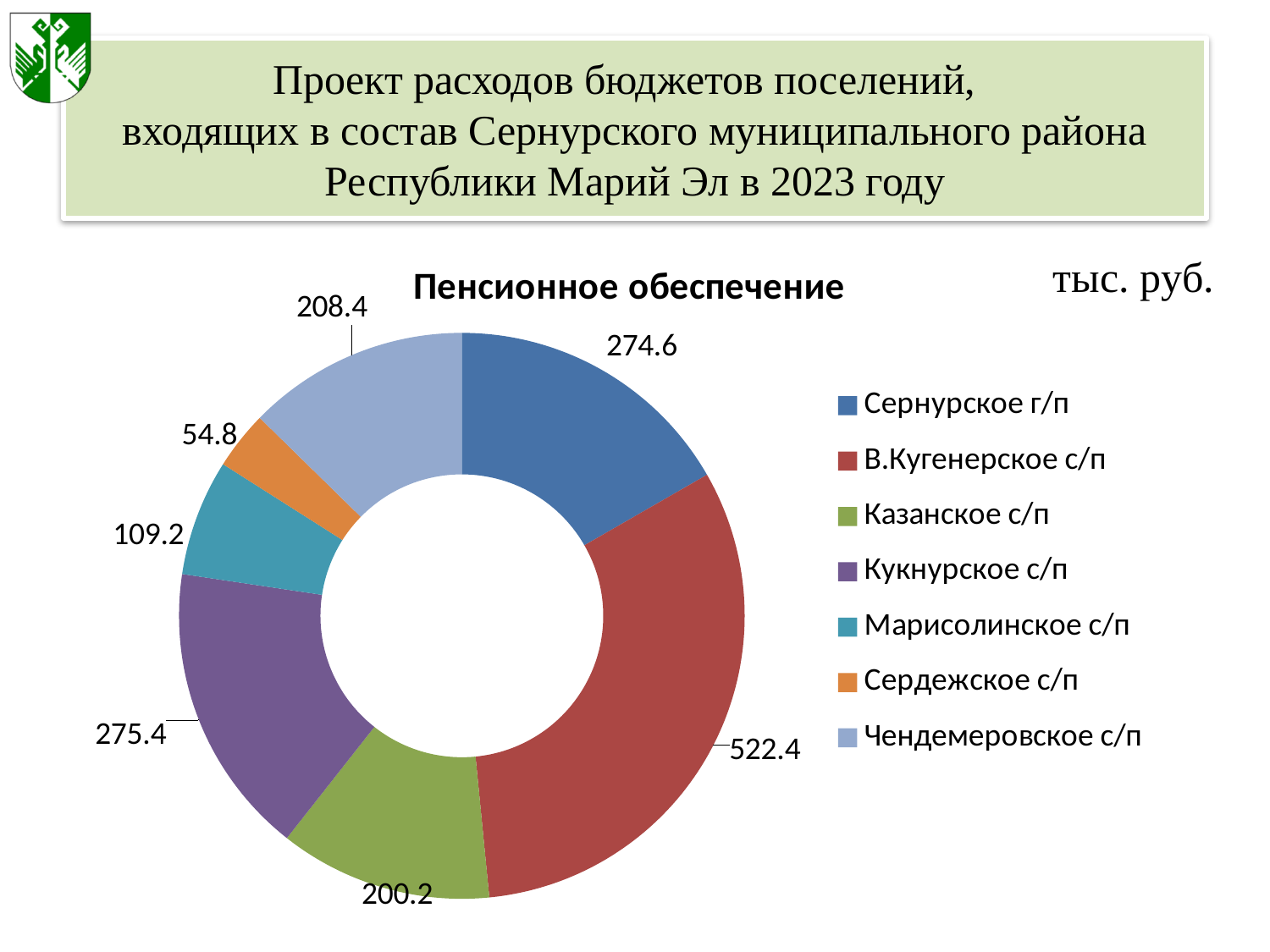
What is the difference between the values for В.Кугенерское с/п and Казанское с/п? 322.2 What is the value for Сердежское с/п? 54.8 Which is larger, the value for Кукнурское с/п or the value for Марисолинское с/п? Кукнурское с/п How many categories does the legend list? 7 What is the value for В.Кугенерское с/п? 522.4 What unit of measurement is indicated next to the chart? тыс. руб. What is the value for Чендемеровское с/п? 208.4 What type of chart is shown on the slide? Doughnut (pie) chart What is the value for Марисолинское с/п? 109.2 Which category has the lowest value? Сердежское с/п Which category has the highest value? В.Кугенерское с/п What is the title of the chart? Пенсионное обеспечение